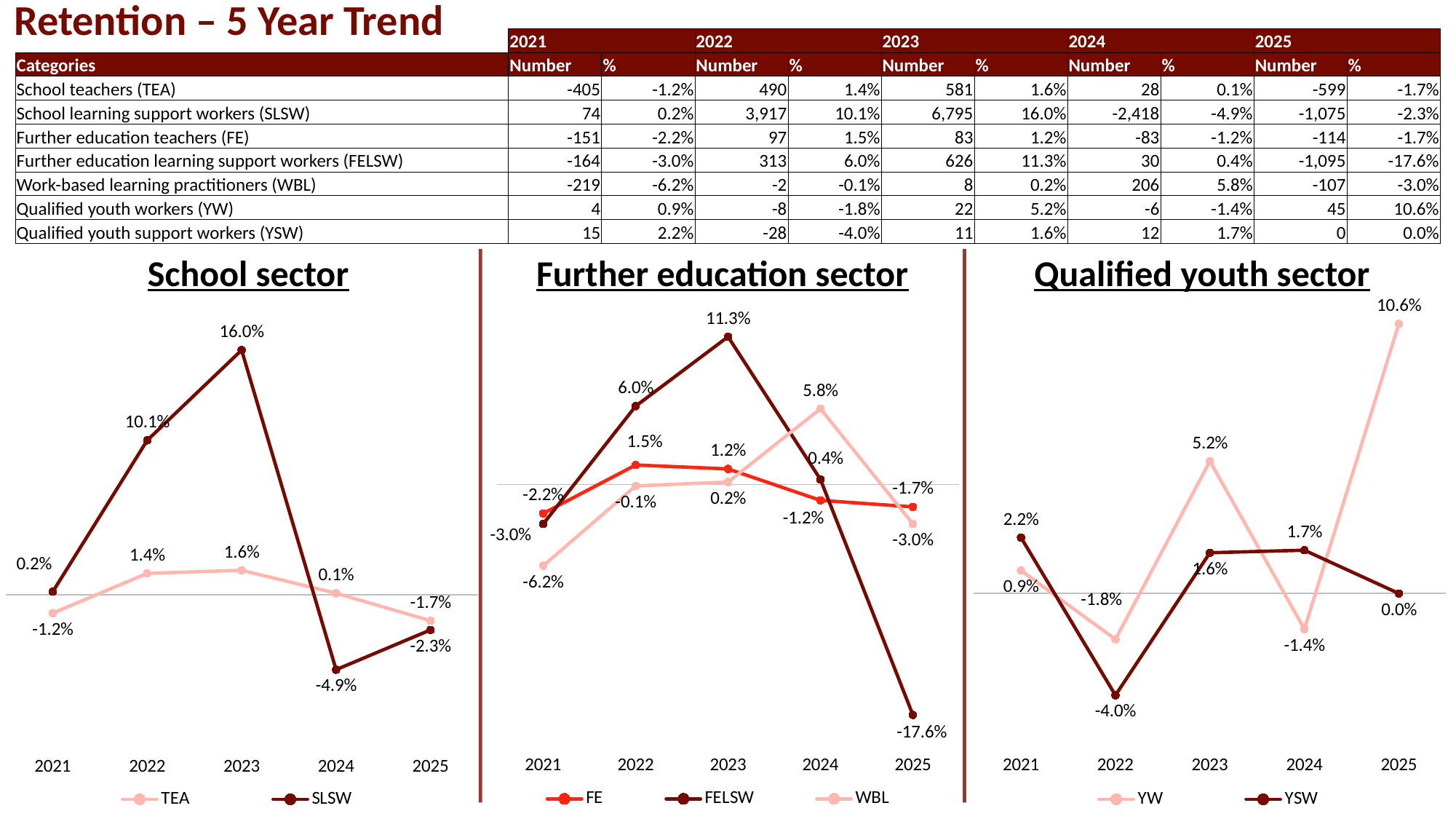
In the Further education sector chart, what is the value for FELSW in 2025? -17.6% In the Qualified youth sector chart, which is larger in 2022, YW or YSW? YW In the School sector chart, in which year is the SLSW value lowest? 2024 In the Further education sector chart, which series has the highest value in 2024? WBL In the Qualified youth sector chart, how many years are plotted on the x axis? 5 In the Qualified youth sector chart, what is the value for YW in 2025? 10.6% In the School sector chart, what is the value for SLSW in 2023? 16.0% In the Qualified youth sector chart, does the YSW value rise or fall from 2024 to 2025? Fall In the School sector chart, what is the difference between the SLSW and TEA values in 2022? 8.7% In the Further education sector chart, how many series does the legend list? 3 In the School sector chart, how many series does the legend list? 2 In the Further education sector chart, what kind of chart is shown? Line chart